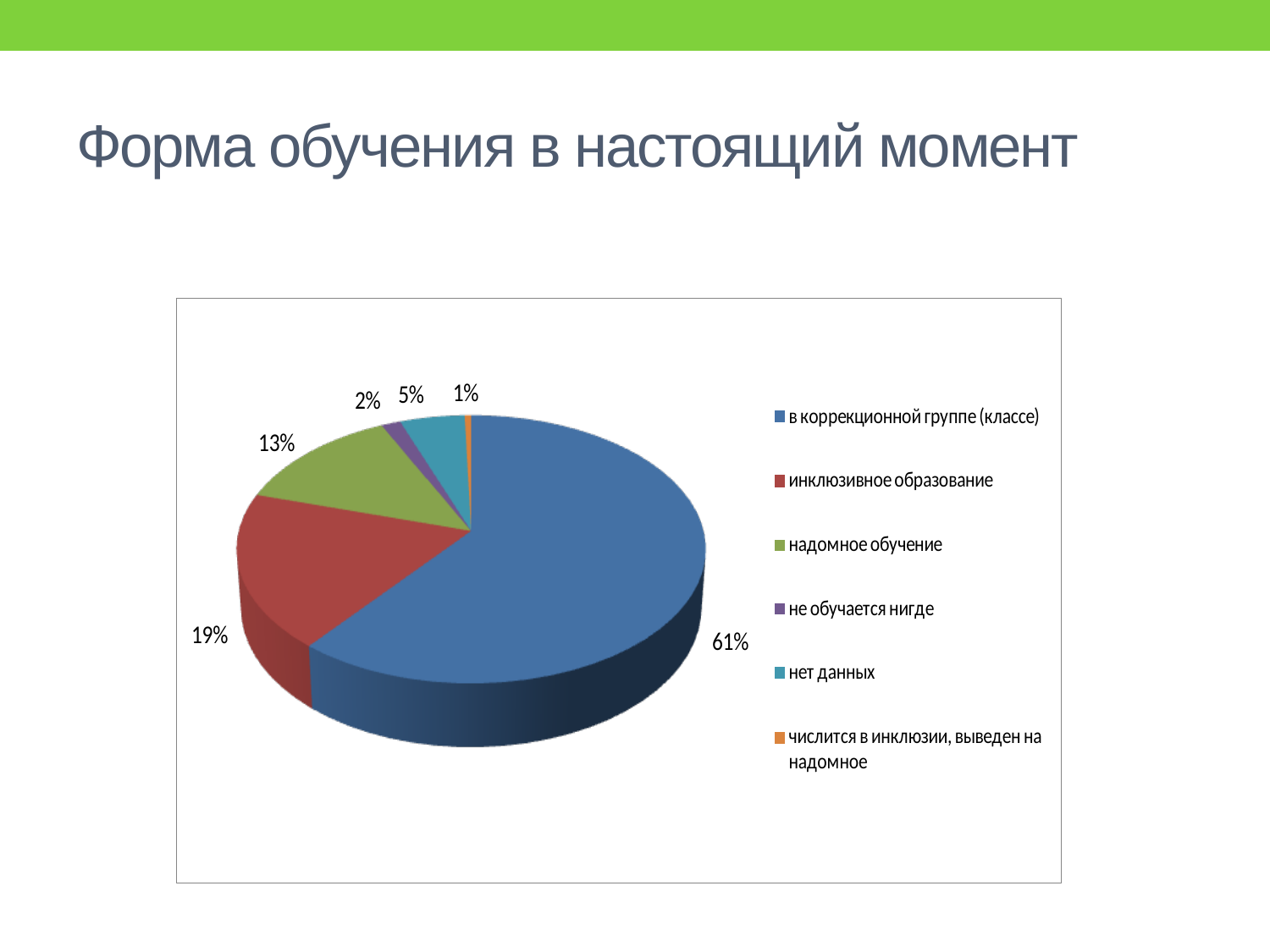
Which is larger: the share for "надомное обучение" or the share for "нет данных"? надомное обучение What percentage is shown for "инклюзивное образование"? 19% Which category has the smallest slice of the pie? числится в инклюзии, выведен на надомное What share of the pie is labelled for "в коррекционной группе (классе)"? 61% What percentage is shown for "нет данных"? 5% What percentage is shown for "не обучается нигде"? 2% What is the title of the slide containing the chart? Форма обучения в настоящий момент Which category has the largest slice of the pie? в коррекционной группе (классе) What is the difference in percentage points between "в коррекционной группе (классе)" and "инклюзивное образование"? 42 What kind of chart is shown on the slide? Pie chart How many categories does the legend list? 6 What percentage is shown for "надомное обучение"? 13%